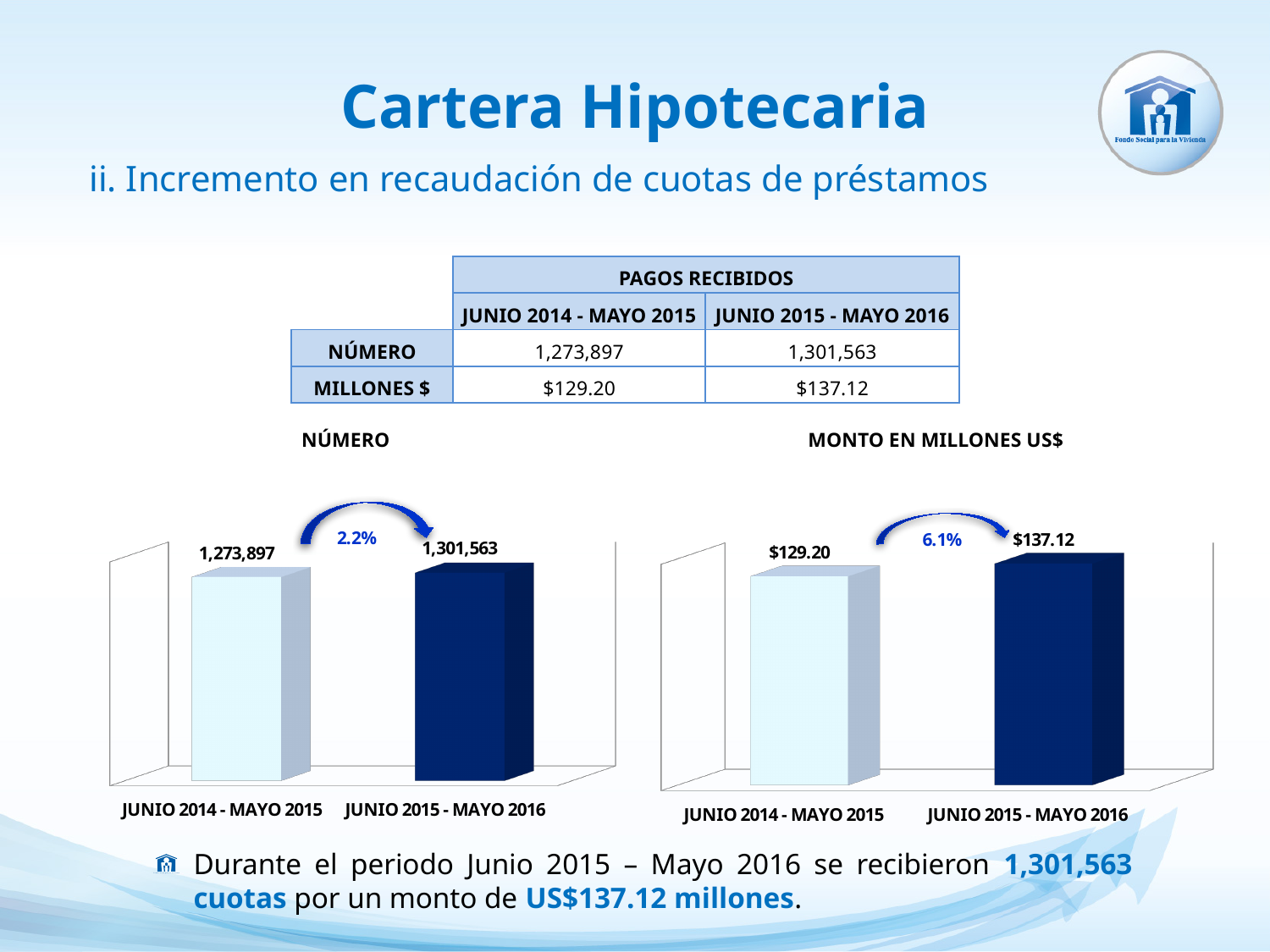
In the MONTO EN MILLONES US$ chart, what is the value for JUNIO 2014 - MAYO 2015? $129.20 In the MONTO EN MILLONES US$ chart, is the value for JUNIO 2015 - MAYO 2016 larger or smaller than the value for JUNIO 2014 - MAYO 2015? larger In the NÚMERO chart, what is the difference between the JUNIO 2015 - MAYO 2016 value and the JUNIO 2014 - MAYO 2015 value? 27,666 What kind of chart is the MONTO EN MILLONES US$ chart? bar chart In the NÚMERO chart, what is the value for JUNIO 2014 - MAYO 2015? 1,273,897 In the MONTO EN MILLONES US$ chart, which period has the lower value? JUNIO 2014 - MAYO 2015 In the MONTO EN MILLONES US$ chart, what is the difference between the JUNIO 2015 - MAYO 2016 value and the JUNIO 2014 - MAYO 2015 value? $7.92 How many bars does the NÚMERO chart show? 2 In the NÚMERO chart, what is the value for JUNIO 2015 - MAYO 2016? 1,301,563 In the NÚMERO chart, which period has the higher value? JUNIO 2015 - MAYO 2016 What percentage increase is shown by the arrow in the MONTO EN MILLONES US$ chart? 6.1% In the MONTO EN MILLONES US$ chart, what is the value for JUNIO 2015 - MAYO 2016? $137.12